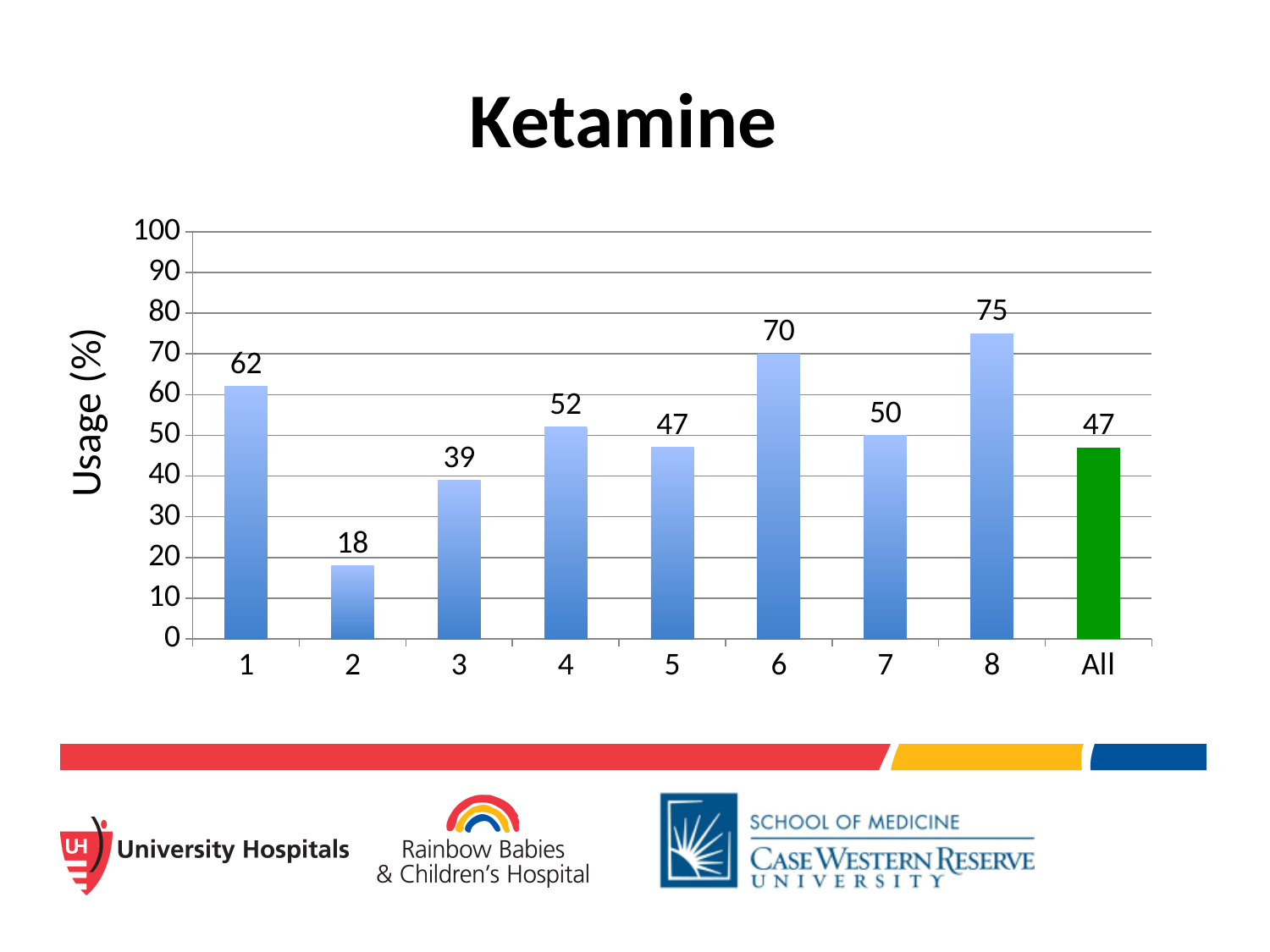
Which has higher ketamine usage, category 3 or category 4? 4 What is the ketamine usage (%) for category 6? 70 What is the difference in usage (%) between category 6 and category 7? 20 What is the difference in usage (%) between category 8 and category 2? 57 Is the value for category 7 greater or less than 40? greater What is the ketamine usage (%) for the 'All' category? 47 How many categories are shown on the x axis? 9 What is the label of the y axis? Usage (%) What kind of chart is shown on the slide? bar chart Which category has the lowest ketamine usage? 2 What is the ketamine usage (%) for category 1? 62 Which category has the highest ketamine usage? 8